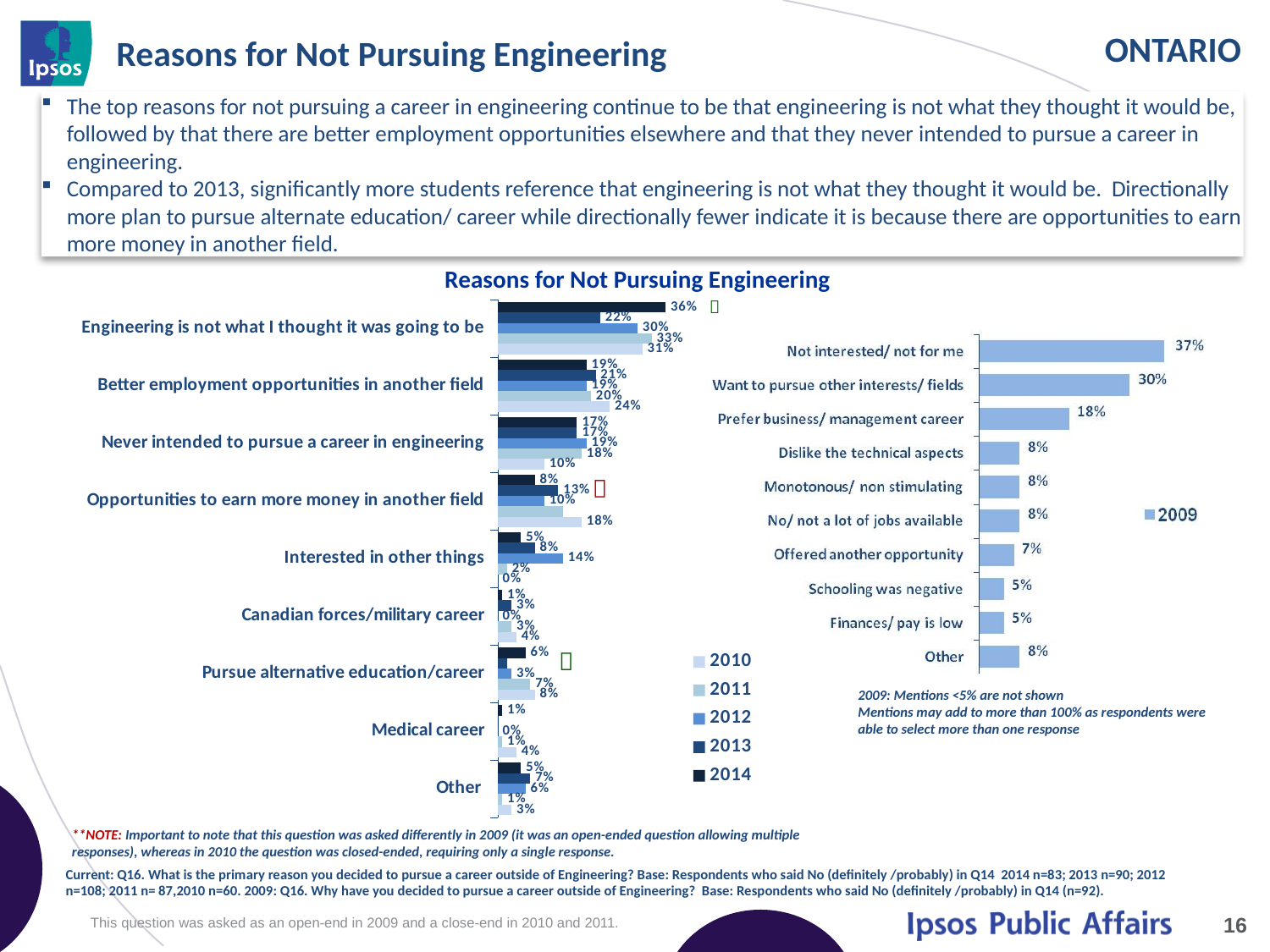
In the left-hand chart 'Reasons for Not Pursuing Engineering', what is the 2014 value for 'Engineering is not what I thought it was going to be'? 36% In the right-hand chart (2009), what percentage of respondents said 'Not interested/ not for me'? 37% In the left-hand chart 'Reasons for Not Pursuing Engineering', how many years does the legend list? 5 In the left-hand chart 'Reasons for Not Pursuing Engineering', what is the 2010 value for 'Opportunities to earn more money in another field'? 18% In the right-hand chart (2009), which reason has the highest percentage? Not interested/ not for me How many reasons (categories) are listed in the right-hand chart (2009)? 10 In the right-hand chart (2009), what is the value for 'Prefer business/ management career'? 18% What is the title of the left-hand chart? Reasons for Not Pursuing Engineering In the right-hand chart (2009), what is the difference between 'Not interested/ not for me' and 'Want to pursue other interests/ fields'? 7% In the left-hand chart 'Reasons for Not Pursuing Engineering', which is larger for 2014: 'Better employment opportunities in another field' or 'Opportunities to earn more money in another field'? Better employment opportunities in another field What type of chart is the right-hand chart (2009)? Bar chart In the left-hand chart 'Reasons for Not Pursuing Engineering', what is the 2013 value for 'Engineering is not what I thought it was going to be'? 22%